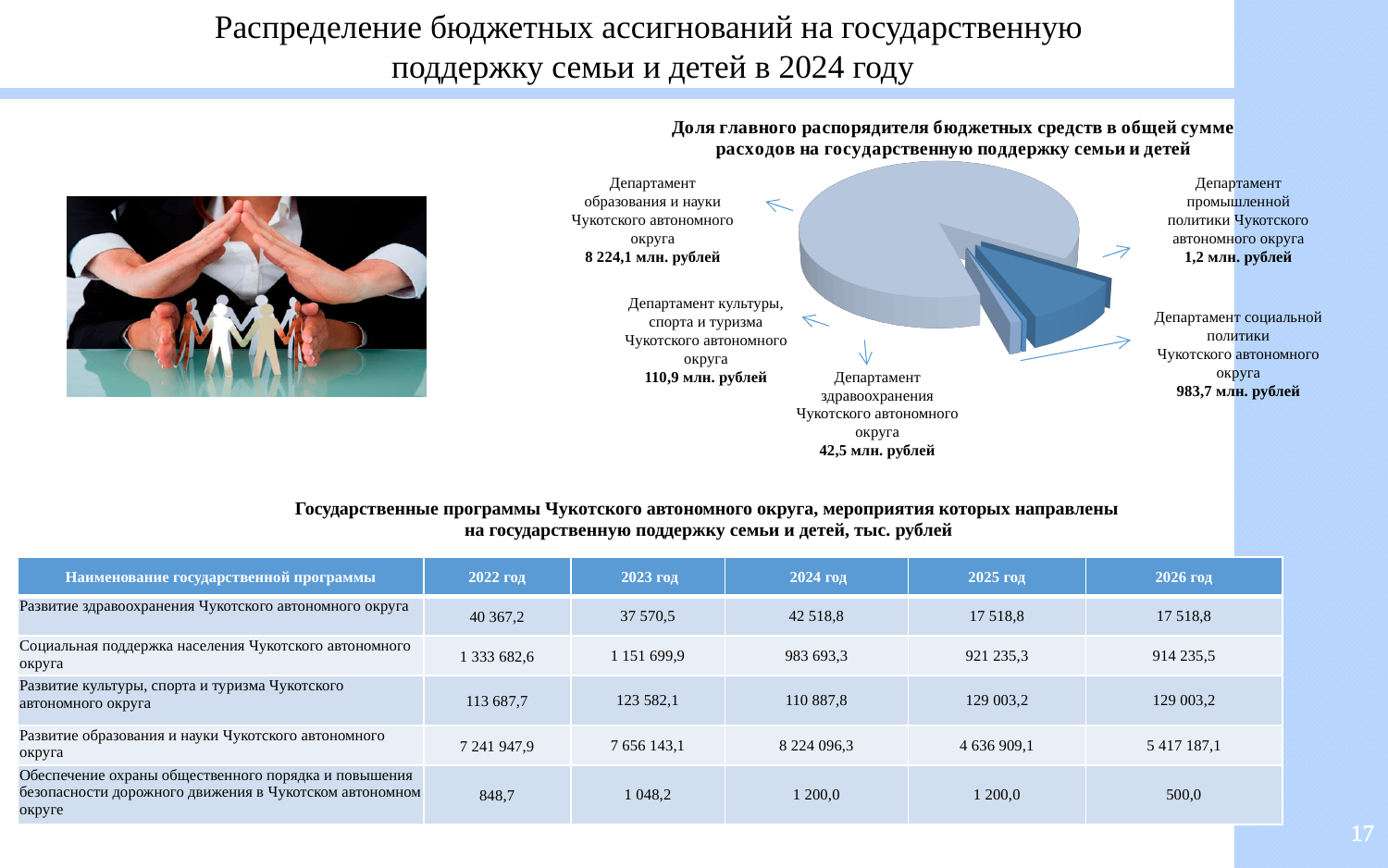
What value is shown for Департамент социальной политики Чукотского автономного округа in the pie chart? 983,7 млн. рублей What is the difference between the values for Департамент образования и науки and Департамент социальной политики in the pie chart? 7 240,4 млн. рублей In the pie chart, which is larger: the value for Департамент культуры, спорта и туризма or for Департамент здравоохранения? Департамент культуры, спорта и туризма What is the title of the pie chart? Доля главного распорядителя бюджетных средств в общей сумме расходов на государственную поддержку семьи и детей Which department has the smallest share in the pie chart? Департамент промышленной политики Чукотского автономного округа What value is shown for Департамент культуры, спорта и туризма Чукотского автономного округа in the pie chart? 110,9 млн. рублей What value is shown for Департамент промышленной политики Чукотского автономного округа in the pie chart? 1,2 млн. рублей What value is shown for Департамент здравоохранения Чукотского автономного округа in the pie chart? 42,5 млн. рублей How many slices (departments) does the pie chart show? 5 Which department has the largest share in the pie chart? Департамент образования и науки Чукотского автономного округа What value is shown for Департамент образования и науки Чукотского автономного округа in the pie chart? 8 224,1 млн. рублей What type of chart is shown on the slide? Pie chart